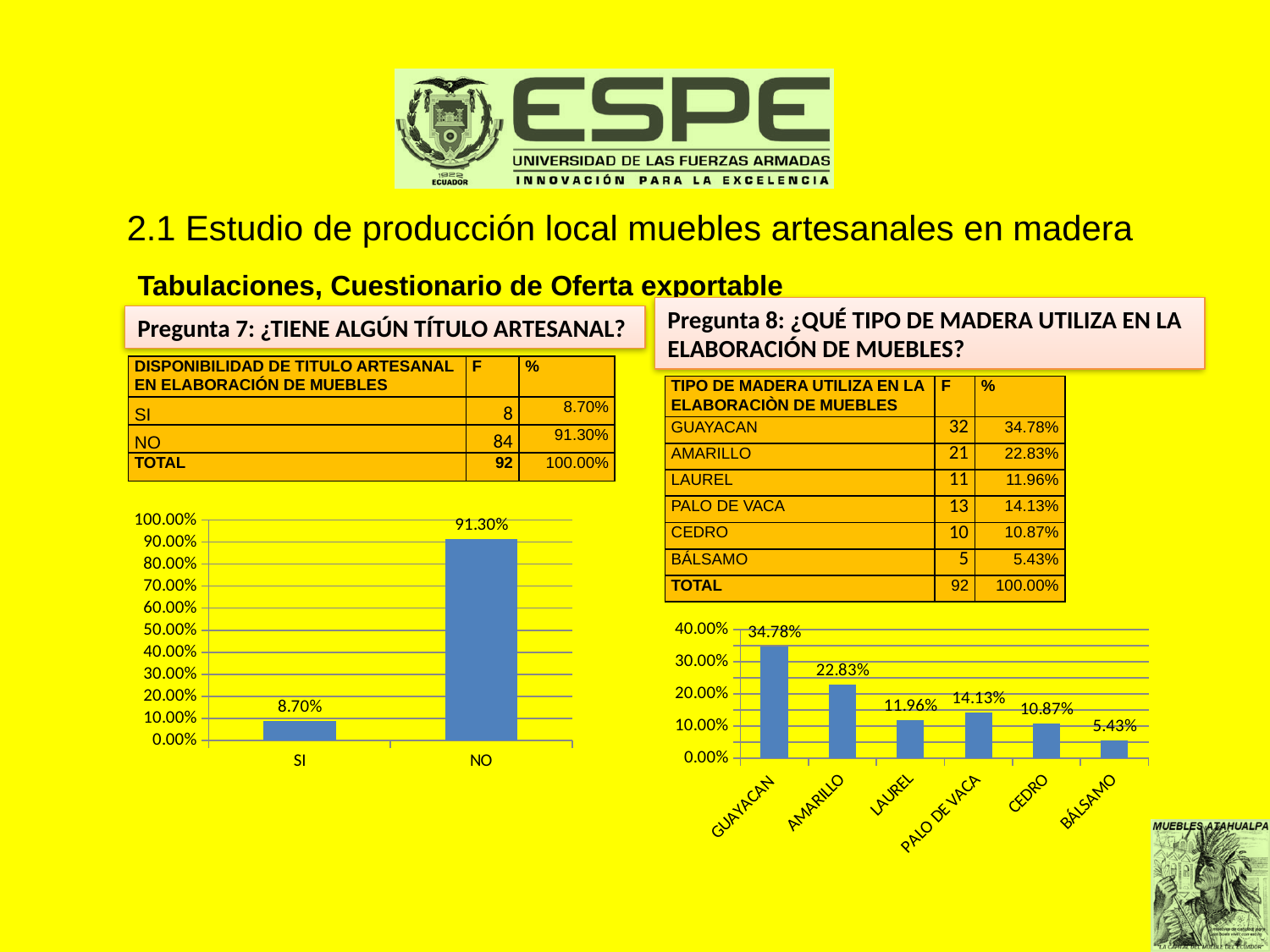
In the right chart (Pregunta 8), what is the value for GUAYACAN? 34.78% In the left chart (Pregunta 7), what is the value for NO? 91.30% In the right chart (Pregunta 8), which category has the lowest value? BÁLSAMO In the right chart (Pregunta 8), how many categories are plotted? 6 In the right chart (Pregunta 8), which category has the highest value? GUAYACAN What kind of chart is shown under Pregunta 8? Bar chart In the left chart (Pregunta 7), how many categories are plotted? 2 In the right chart (Pregunta 8), which is larger, the value for AMARILLO or the value for CEDRO? AMARILLO In the right chart (Pregunta 8), what is the value for PALO DE VACA? 14.13% In the left chart (Pregunta 7), what is the difference between the values for NO and SI? 82.60% In the left chart (Pregunta 7), what is the value for SI? 8.70% In the right chart (Pregunta 8), what is the difference between the values for GUAYACAN and AMARILLO? 11.95%